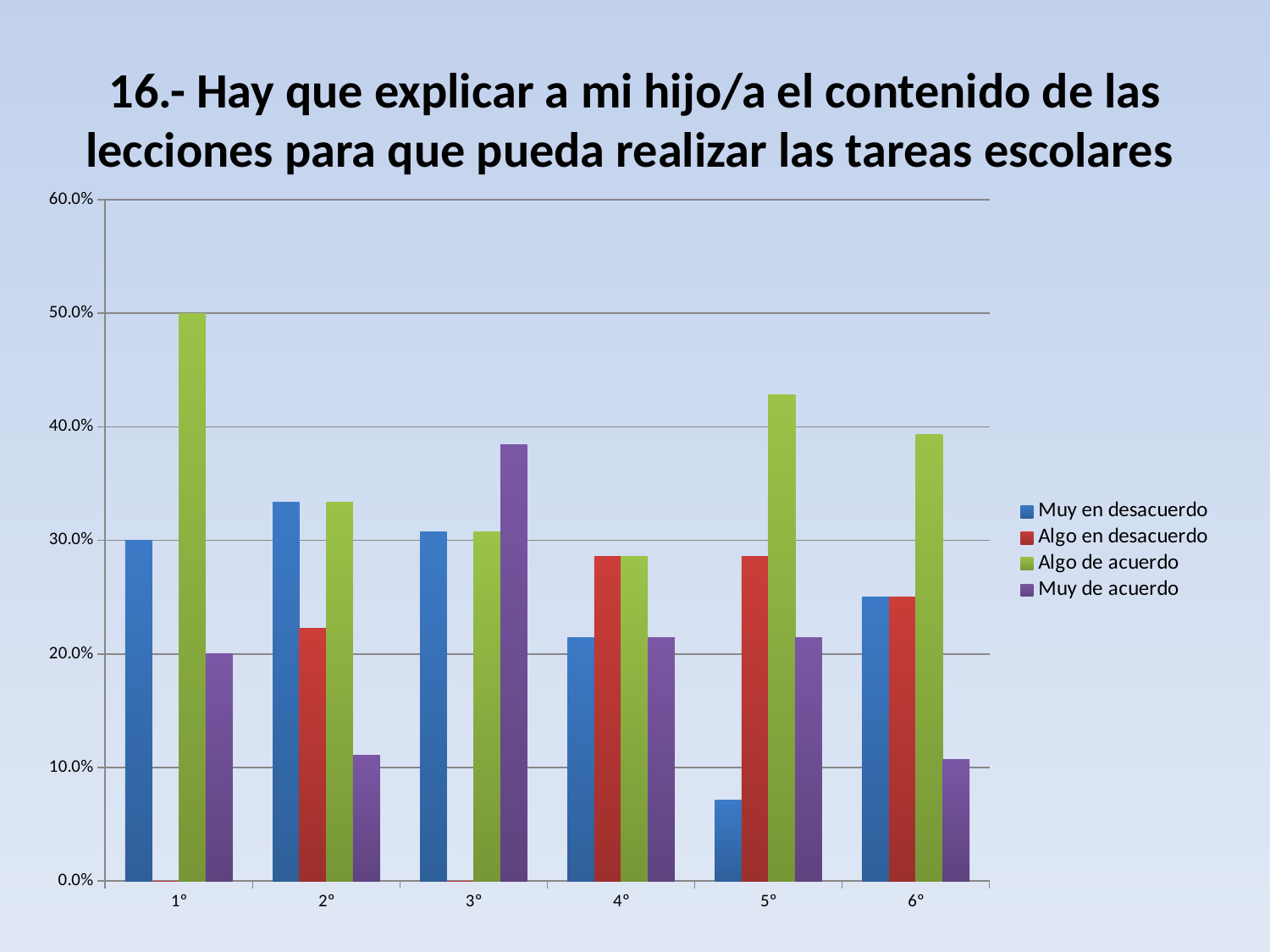
Which series is shown in green in the legend? Algo de acuerdo Which category has the highest value for 'Algo de acuerdo'? 1° What kind of chart is shown on the slide? bar chart In category 3°, which is larger: 'Muy de acuerdo' or 'Muy en desacuerdo'? Muy de acuerdo What is the value for 'Muy de acuerdo' in category 1°? 20.0% Is the value for 'Algo de acuerdo' in category 5° greater or less than 40.0%? greater Which category has the lowest value for 'Muy en desacuerdo'? 5° What is the value for 'Algo de acuerdo' in category 1°? 50.0% What is the value for 'Muy en desacuerdo' in category 1°? 30.0% Is the value for 'Muy de acuerdo' in category 6° greater or less than 20.0%? less How many series does the legend list? 4 How many categories are shown on the x axis? 6